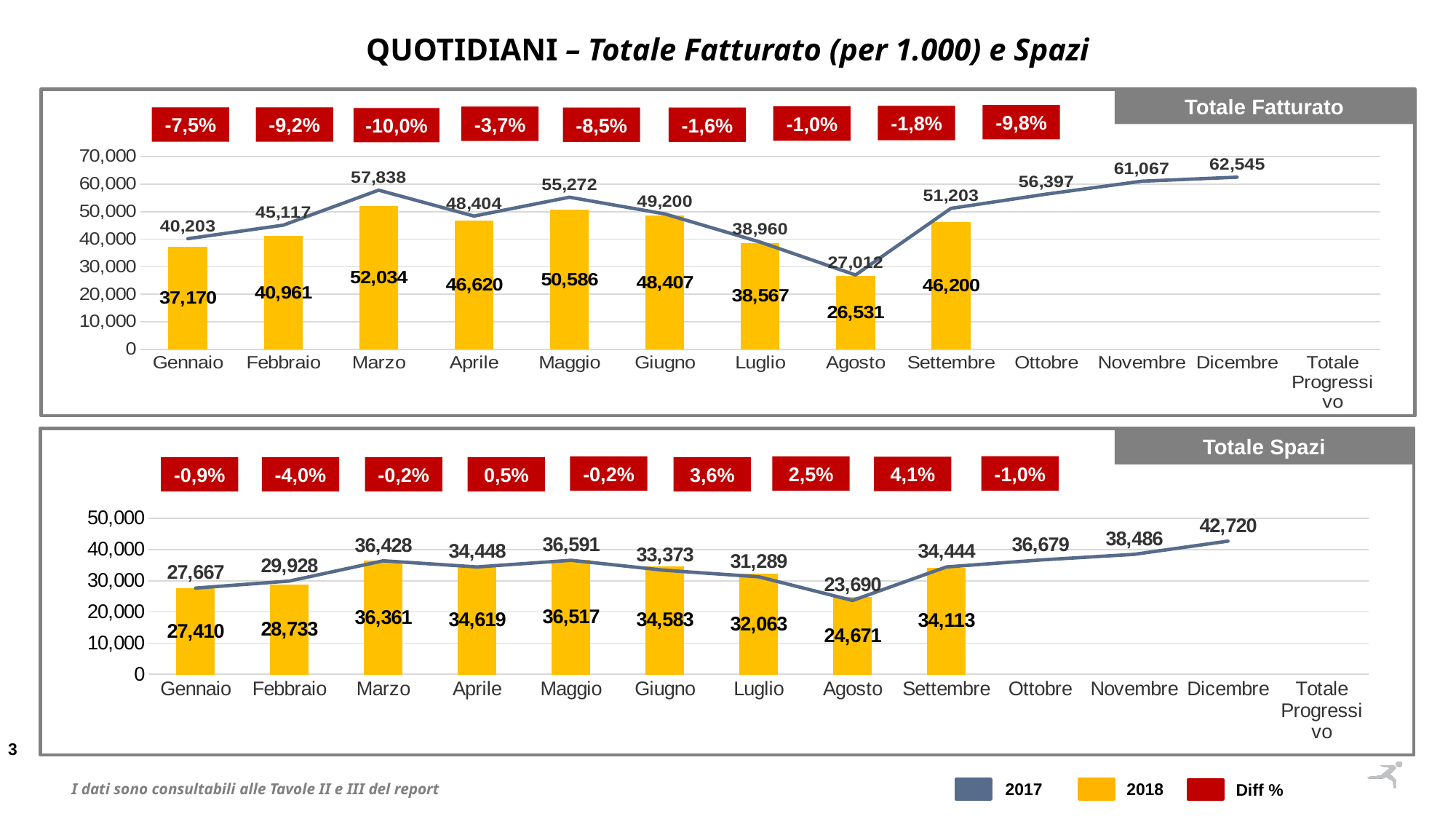
In the Totale Spazi chart, what is the 2018 value for Agosto? 24,671 In the Totale Fatturato chart, which month has the lowest 2018 bar? Agosto In the Totale Fatturato chart, what is the 2018 value for Marzo? 52,034 In the Totale Fatturato chart, which month has the highest 2018 bar? Marzo How many series does the legend at the bottom of the slide list? 3 In the Totale Fatturato chart, how many months have a 2018 bar plotted? 9 In the Totale Fatturato chart, what is the 2017 value for Dicembre? 62,545 In the Totale Spazi chart, for Giugno, which is larger: the 2017 value or the 2018 value? 2018 In the Totale Spazi chart, what is the Diff % shown for Settembre? 4,1% In the Totale Fatturato chart, what is the difference between the 2017 and 2018 values for Gennaio? 3,033 In the Totale Fatturato chart, what is the Diff % shown for Marzo? -10,0% In the Totale Spazi chart, which month has the highest 2017 value? Dicembre